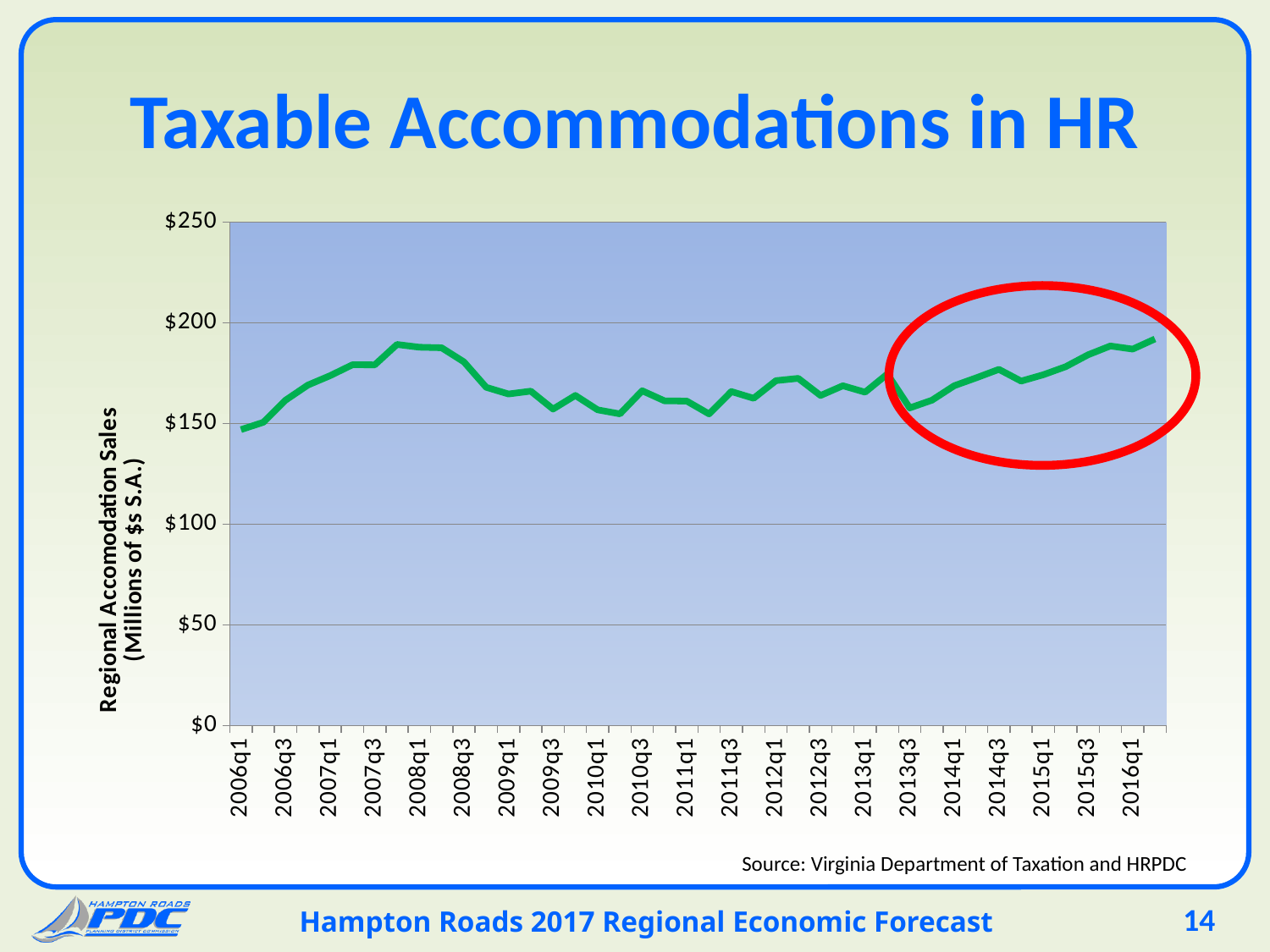
What is the label on the vertical axis of the chart? Regional Accomodation Sales (Millions of $s S.A.) Do the values rise or fall from 2008q1 to 2009q3? fall Is the value for 2008q1 greater or less than $200? less What is the title of the chart on the slide? Taxable Accommodations in HR Which quarter has the lowest value on the chart? 2006q1 Is the value for 2006q1 greater or less than $150? less Is the value for 2016q1 larger or smaller than the value for 2006q1? larger Is the value for 2016q1 greater or less than $150? greater What kind of chart is shown on the slide? line chart Do the values rise or fall from 2013q3 to 2016q1? rise